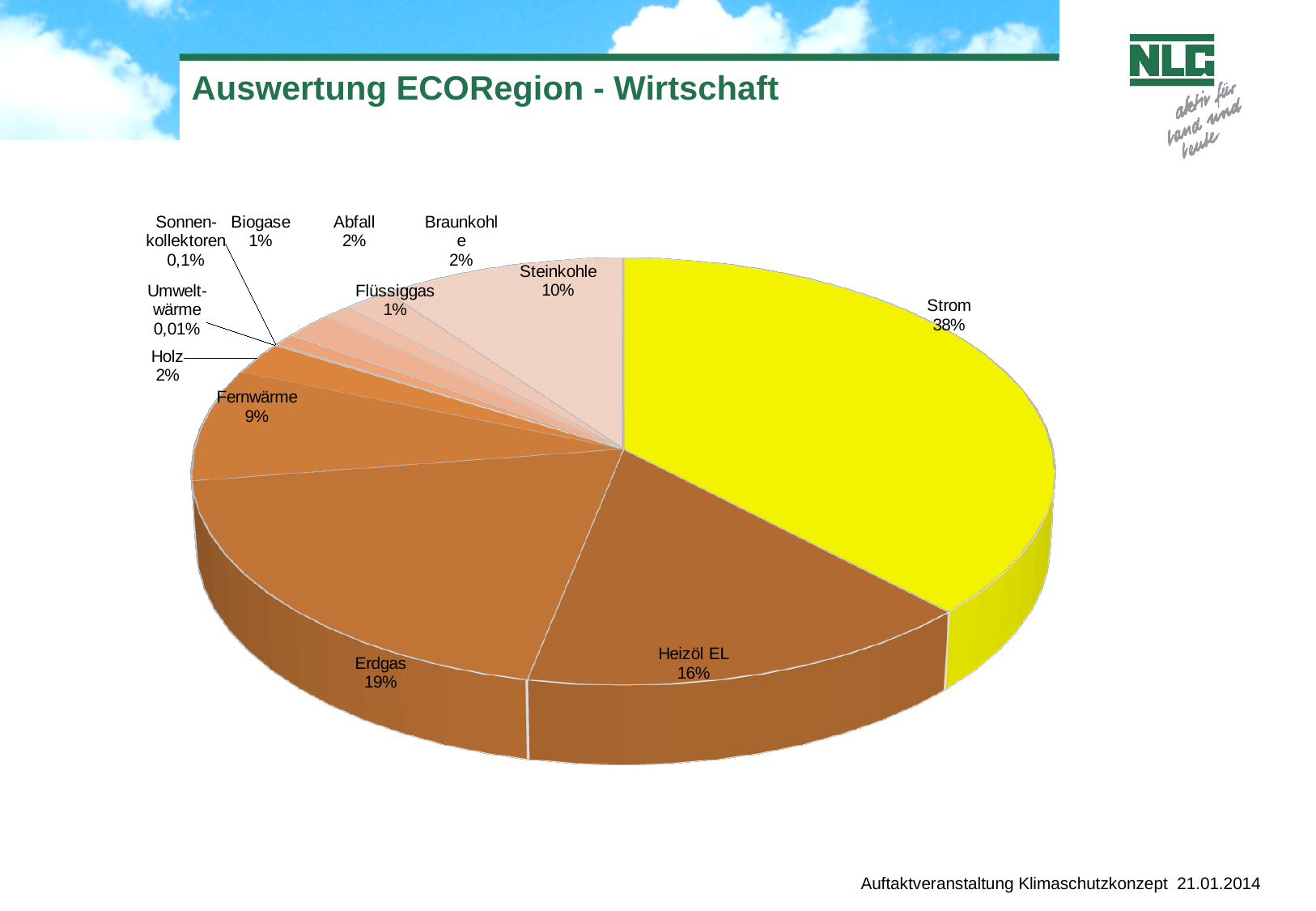
What share of the pie does Umweltwärme have? 0,01% What share of the pie does Fernwärme have? 9% What is the difference in percentage points between Strom and Erdgas? 19 What share of the pie does Erdgas have? 19% Which category has the smallest share of the pie? Umweltwärme Which has the larger share, Steinkohle or Fernwärme? Steinkohle What share of the pie does Heizöl EL have? 16% How many categories are shown in the pie chart? 12 What share of the pie does Sonnenkollektoren have? 0,1% Which category has the largest share of the pie? Strom What share of the pie does Strom have? 38% What kind of chart is shown on the slide? Pie chart